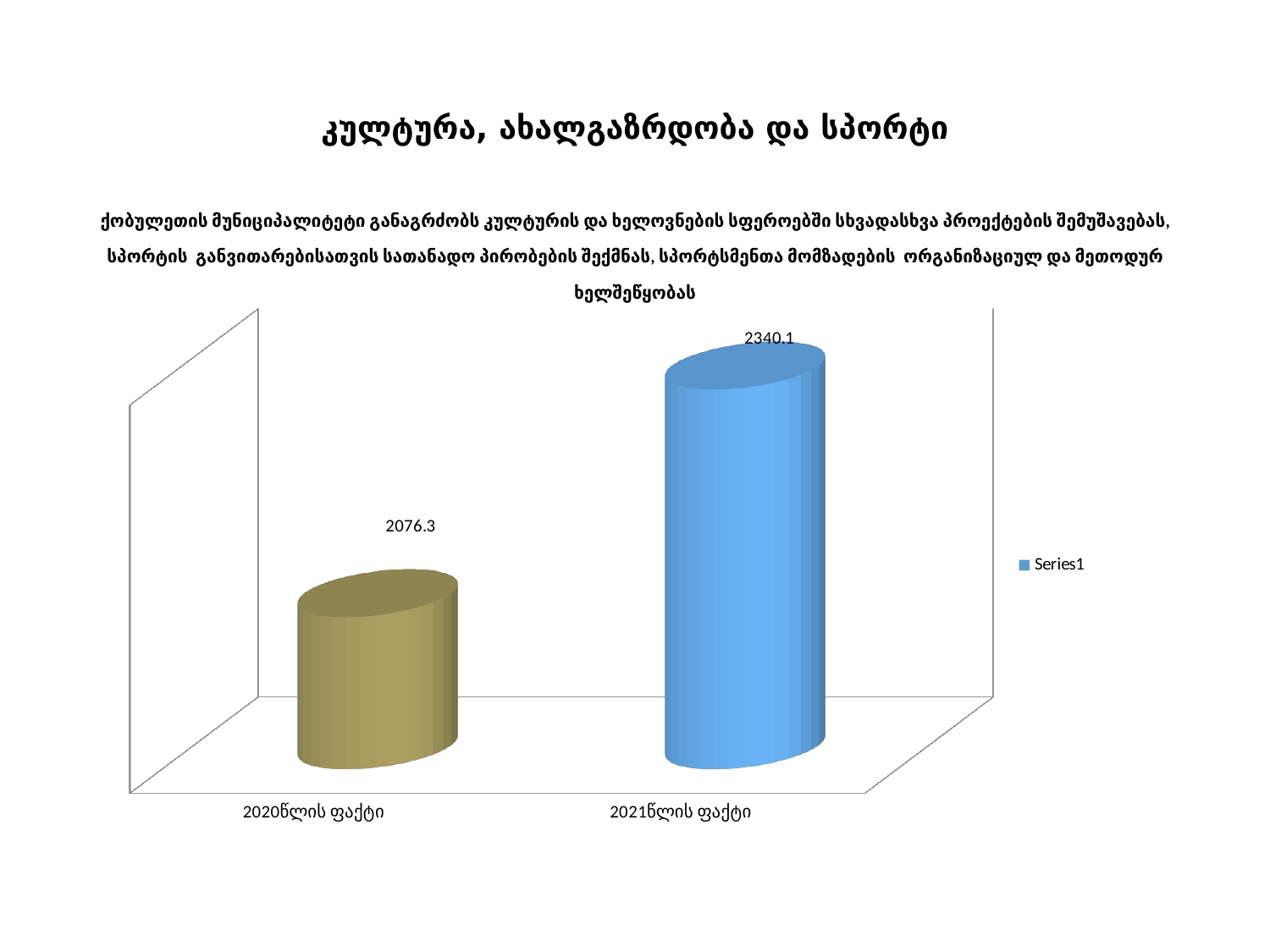
How many series does the legend list? 1 What is the value for 2021წლის ფაქტი? 2340.1 What is the title of the slide? კულტურა, ახალგაზრდობა და სპორტი What is the difference between the values for 2021წლის ფაქტი and 2020წლის ფაქტი? 263.8 Do the values rise or fall from 2020წლის ფაქტი to 2021წლის ფაქტი? Rise Which category has the highest value? 2021წლის ფაქტი What is the name of the series listed in the legend? Series1 What is the value for 2020წლის ფაქტი? 2076.3 Which category has the lowest value? 2020წლის ფაქტი Which is larger, the value for 2020წლის ფაქტი or the value for 2021წლის ფაქტი? 2021წლის ფაქტი What kind of chart is shown on the slide? Bar chart How many categories are shown on the chart? 2